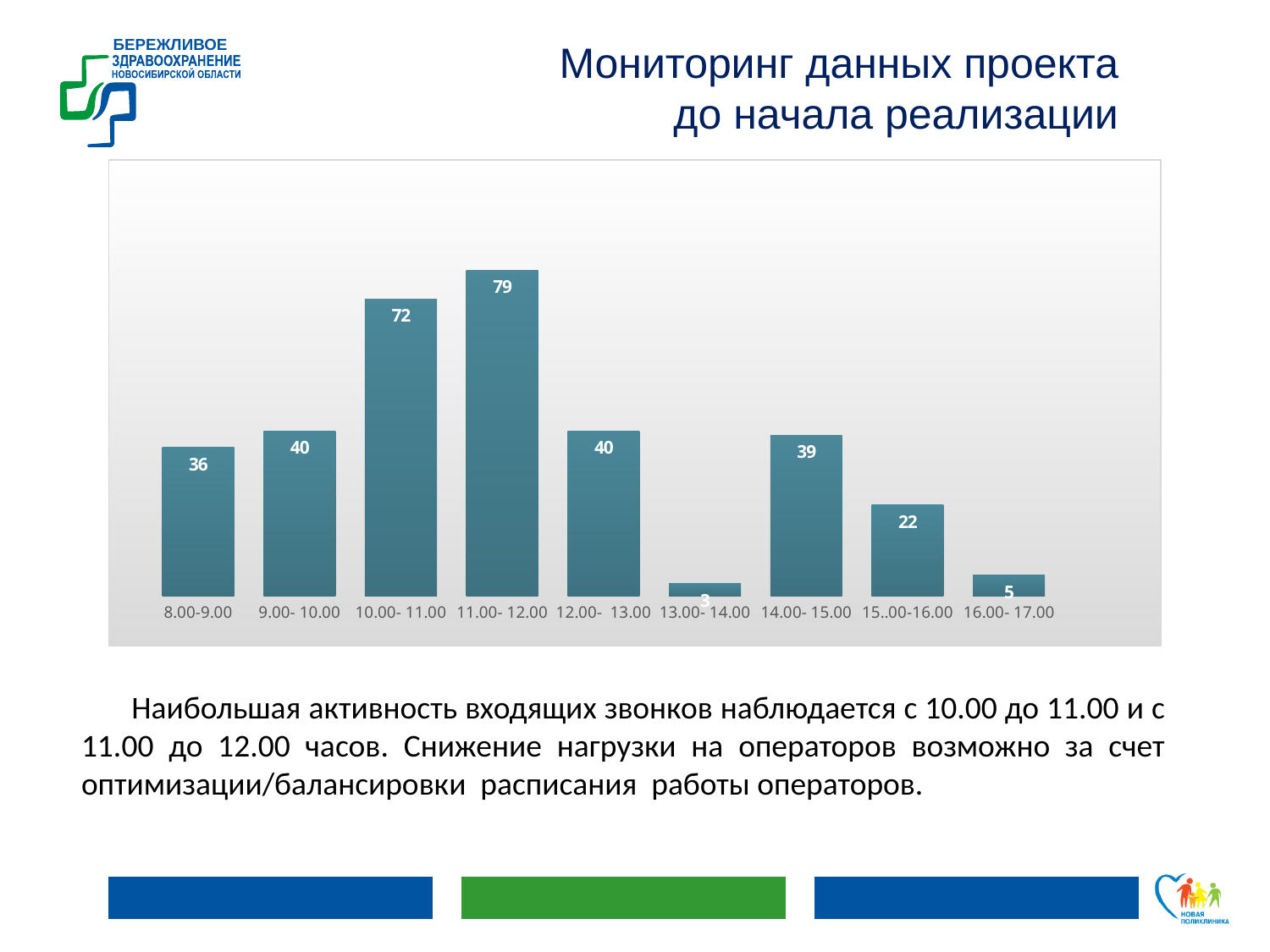
What is the value for the 11.00-12.00 time slot? 79 Which is larger, the value for 9.00-10.00 or the value for 14.00-15.00? 9.00-10.00 What is the value for the 15..00-16.00 time slot? 22 Which is larger, the value for 15..00-16.00 or the value for 13.00-14.00? 15..00-16.00 Which time slot has the lowest value? 13.00-14.00 What is the difference between the values for 14.00-15.00 and 16.00-17.00? 34 What is the difference between the values for 11.00-12.00 and 10.00-11.00? 7 Do the values rise or fall from 11.00-12.00 to 13.00-14.00? fall What is the value for the 8.00-9.00 time slot? 36 What kind of chart is shown on the slide? bar chart Which time slot has the highest value? 11.00-12.00 How many time slots are shown on the chart? 9